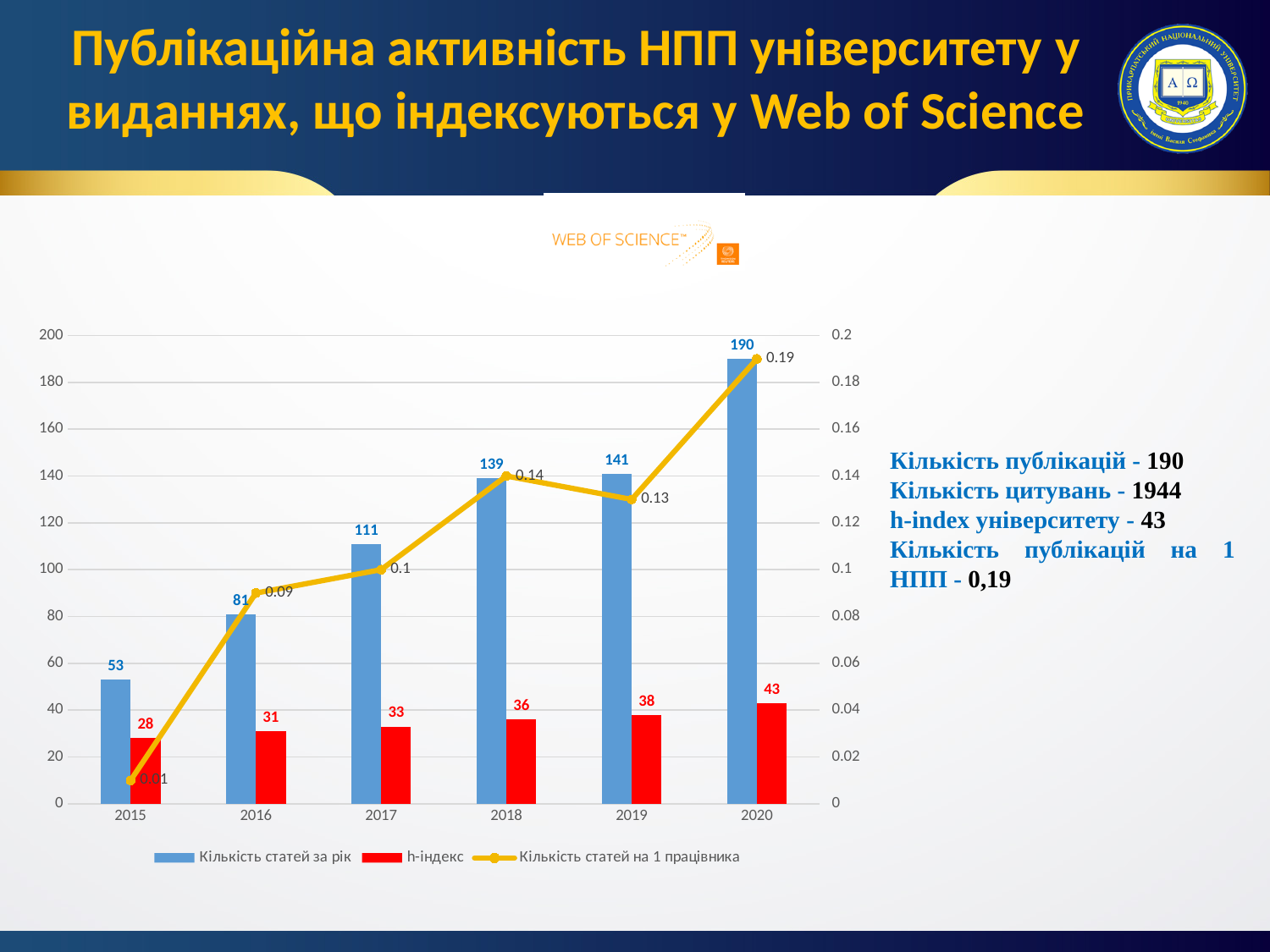
What kind of chart is shown on the slide? Combined bar and line chart What colour are the bars for "h-індекс"? Red Does the "h-індекс" series rise or fall from 2015 to 2020? Rise How many series does the legend list? 3 Which is larger: "Кількість статей на 1 працівника" in 2018 or in 2019? 2018 What is the value of "Кількість статей за рік" for 2020? 190 Which year has the highest "h-індекс" value? 2020 What is the value of "Кількість статей на 1 працівника" for 2018? 0.14 What is the difference between "Кількість статей за рік" in 2020 and in 2019? 49 What is the "h-індекс" value for 2017? 33 Which year has the lowest value of "Кількість статей за рік"? 2015 How many years are shown on the x axis? 6